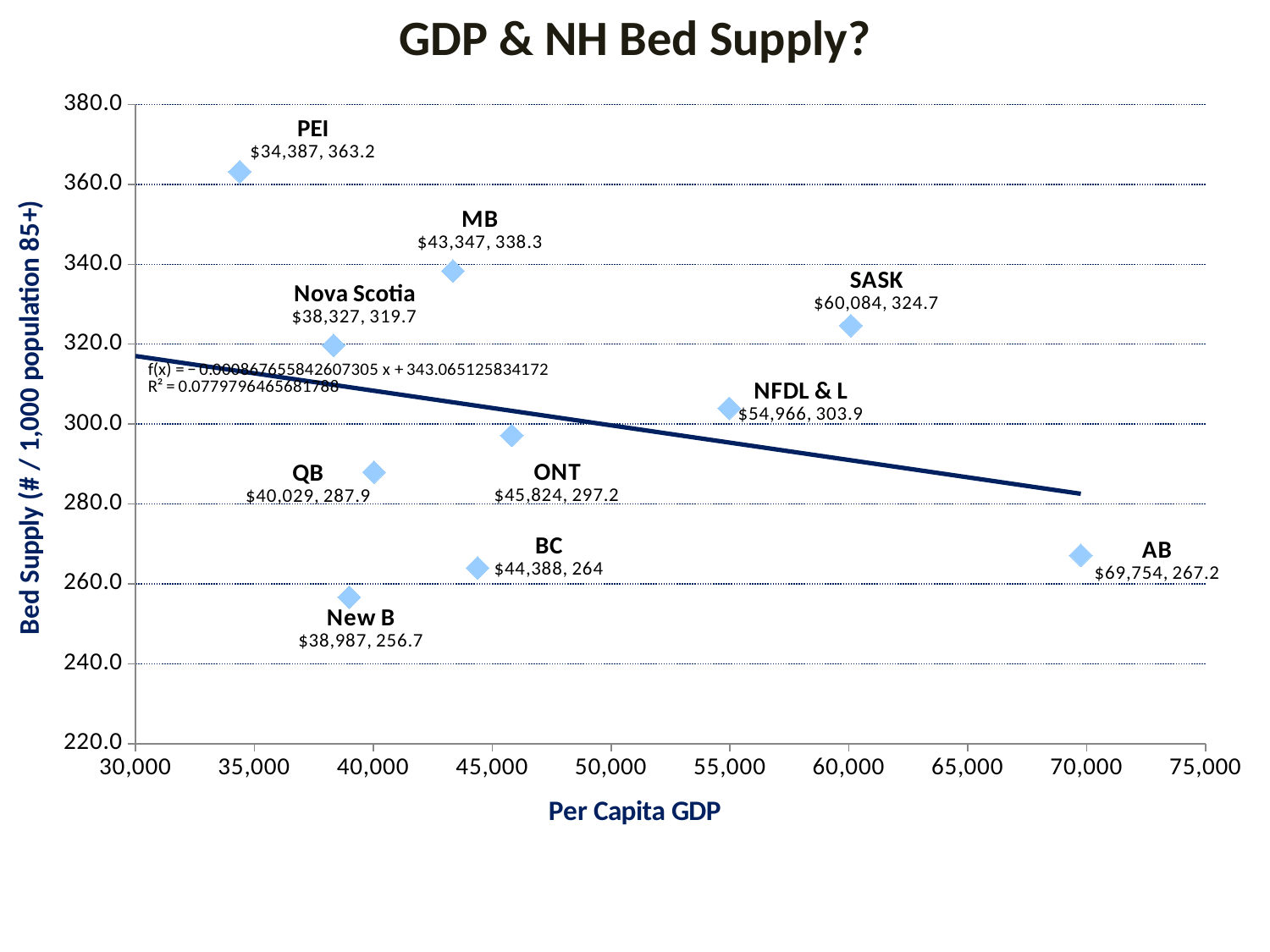
How many provinces are plotted on the chart? 10 What is the difference in bed supply between MB and SASK? 13.6 What is the difference in bed supply between PEI and New B? 106.5 What is the per capita GDP shown for Alberta (AB)? $69,754 Which province has the lowest bed supply? New B What is the bed supply value for PEI? 363.2 Which has a higher bed supply, ONT or QB? ONT Does the trend line rise or fall as per capita GDP increases? Falls Which province has the highest bed supply? PEI Which province has the highest per capita GDP? AB What kind of chart is shown on the slide? Scatter chart What is the bed supply value for Nova Scotia? 319.7